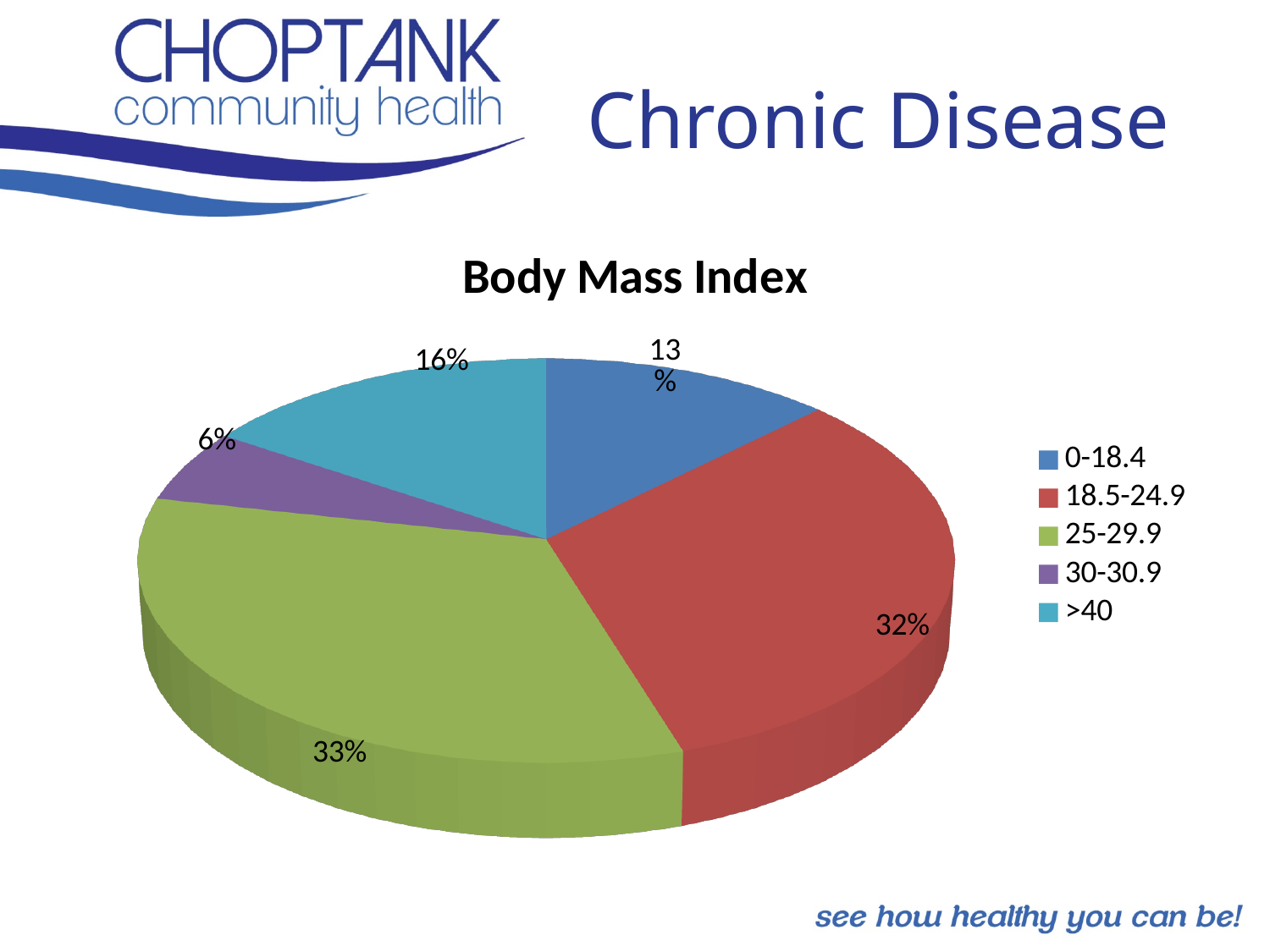
What percentage of the pie is the >40 category? 16% Which category has the largest share of the pie? 25-29.9 How many categories does the legend list? 5 What percentage of the pie is the 18.5-24.9 category? 32% Which category has the smallest share of the pie? 30-30.9 What percentage of the pie is the 25-29.9 category? 33% Which category has a larger share, >40 or 0-18.4? >40 What is the difference in percentage points between the 25-29.9 and 18.5-24.9 categories? 1 What is the title of the chart? Body Mass Index What percentage of the pie is the 30-30.9 category? 6% What percentage of the pie is the 0-18.4 category? 13% What kind of chart is shown on the slide? Pie chart